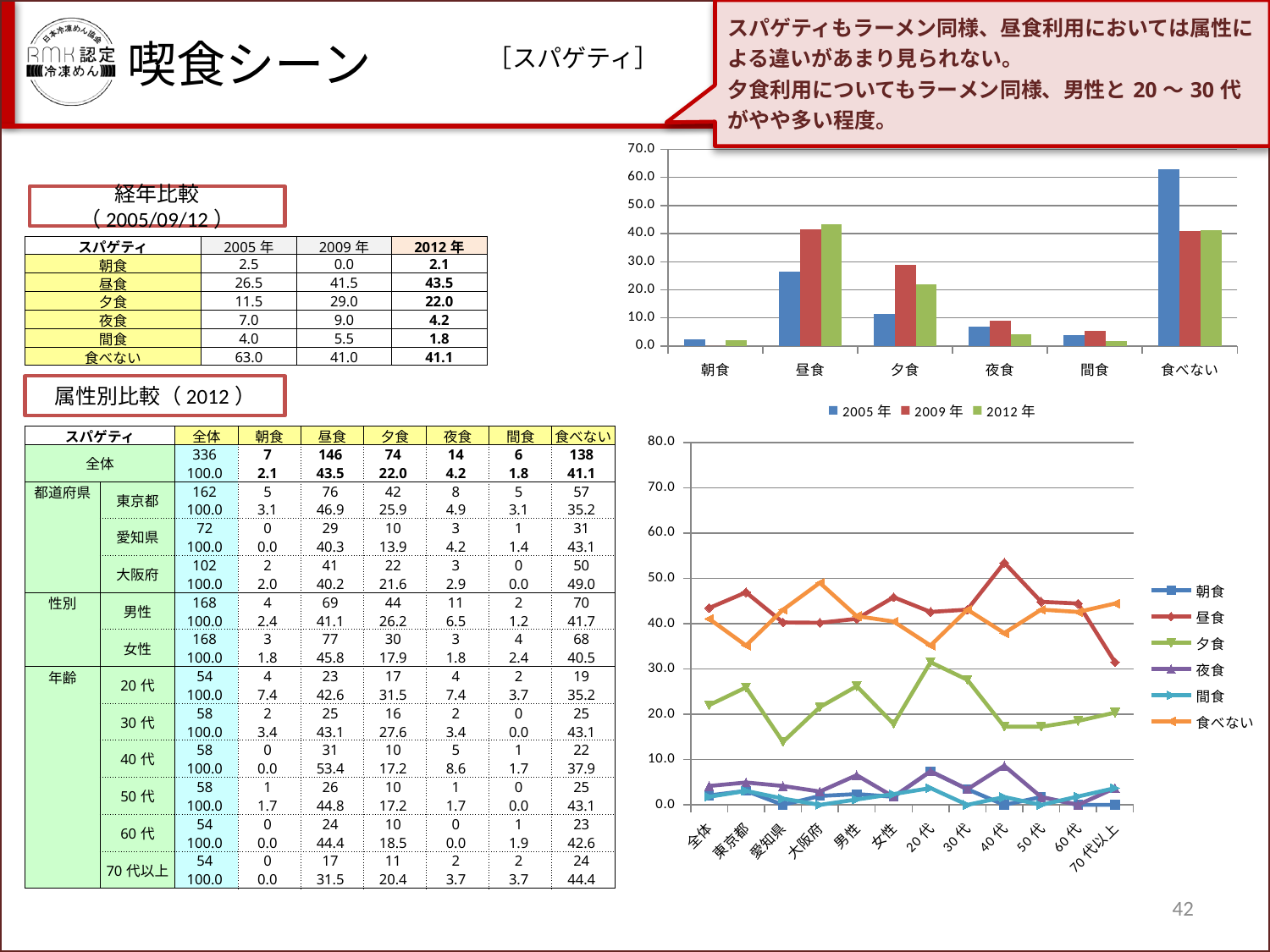
In the bottom-right line chart, how many categories are shown on the x axis? 12 In the top-right bar chart, how many series does the legend list? 3 In the bottom-right line chart, which category has the highest value for 昼食? 40代 In the top-right bar chart, how many categories are shown on the x axis? 6 In the bottom-right line chart, how many series does the legend list? 6 In the top-right bar chart, which is larger for 夕食: the 2009年 value or the 2012年 value? 2009年 In the top-right bar chart, which category has the lowest value for 2009年? 朝食 In the bottom-right line chart, is the 夕食 value for 愛知県 greater or less than 20.0? less In the top-right bar chart, which category has the highest value for 2012年? 昼食 In the top-right bar chart, is the value for 食べない in 2005年 greater or less than 60.0? greater What kind of chart is the bottom-right chart on the slide? line chart What kind of chart is the top-right chart on the slide? bar chart